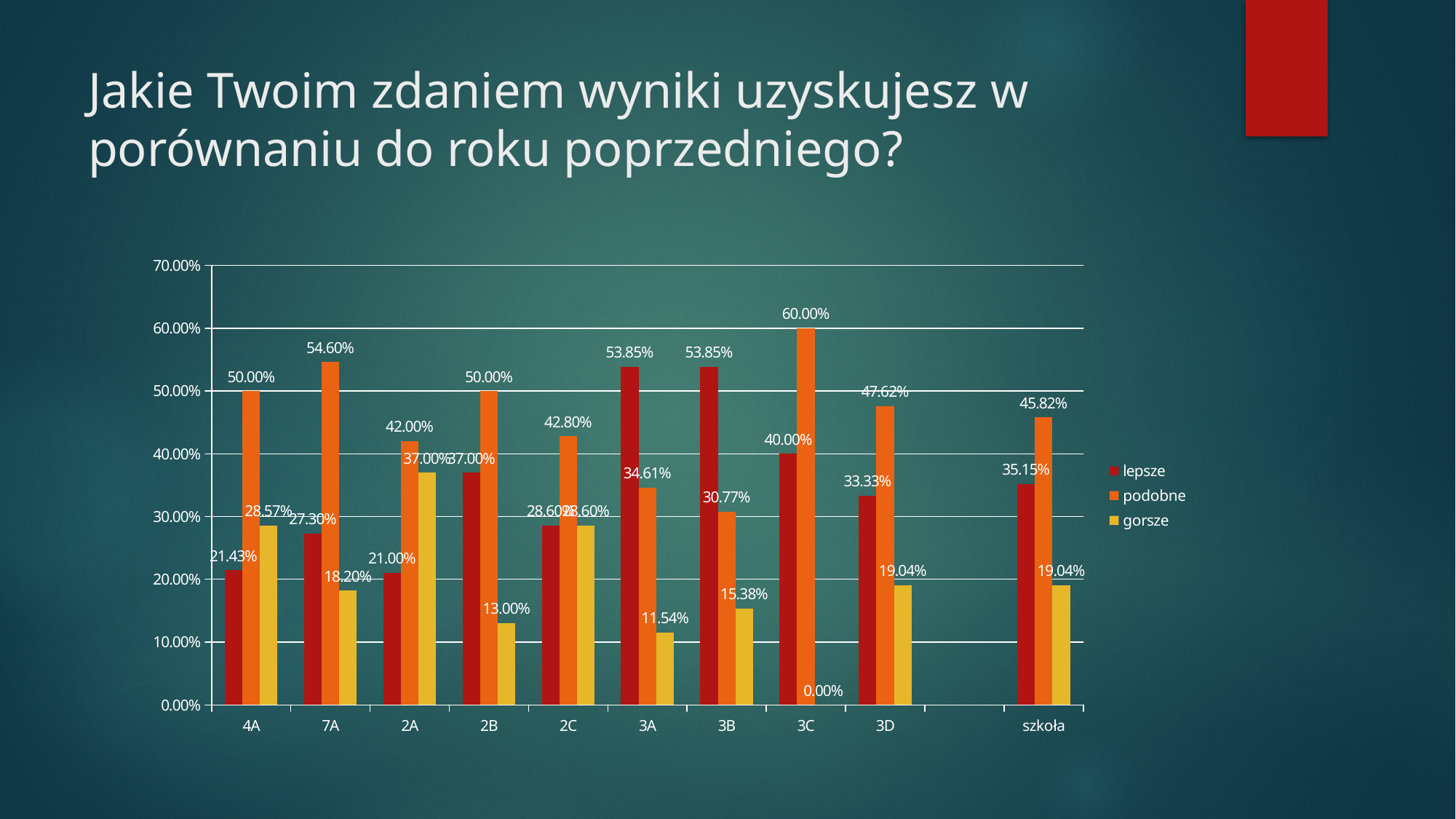
What is the value of the 'gorsze' series for 2B? 13.00% Which category has the lowest 'gorsze' value? 3C How many series does the legend list? 3 Which category has the highest 'podobne' value? 3C What kind of chart is shown on the slide? bar chart What is the difference between the 'podobne' and 'lepsze' values for 3C? 20.00% What is the value of the 'podobne' series for 3C? 60.00% Which is larger for 2A: the 'podobne' value or the 'gorsze' value? podobne How many categories are shown on the x axis? 10 Which category has the highest 'gorsze' value? 2A What is the value of the 'lepsze' series for szkoła? 35.15% What are the three series listed in the legend? lepsze, podobne, gorsze